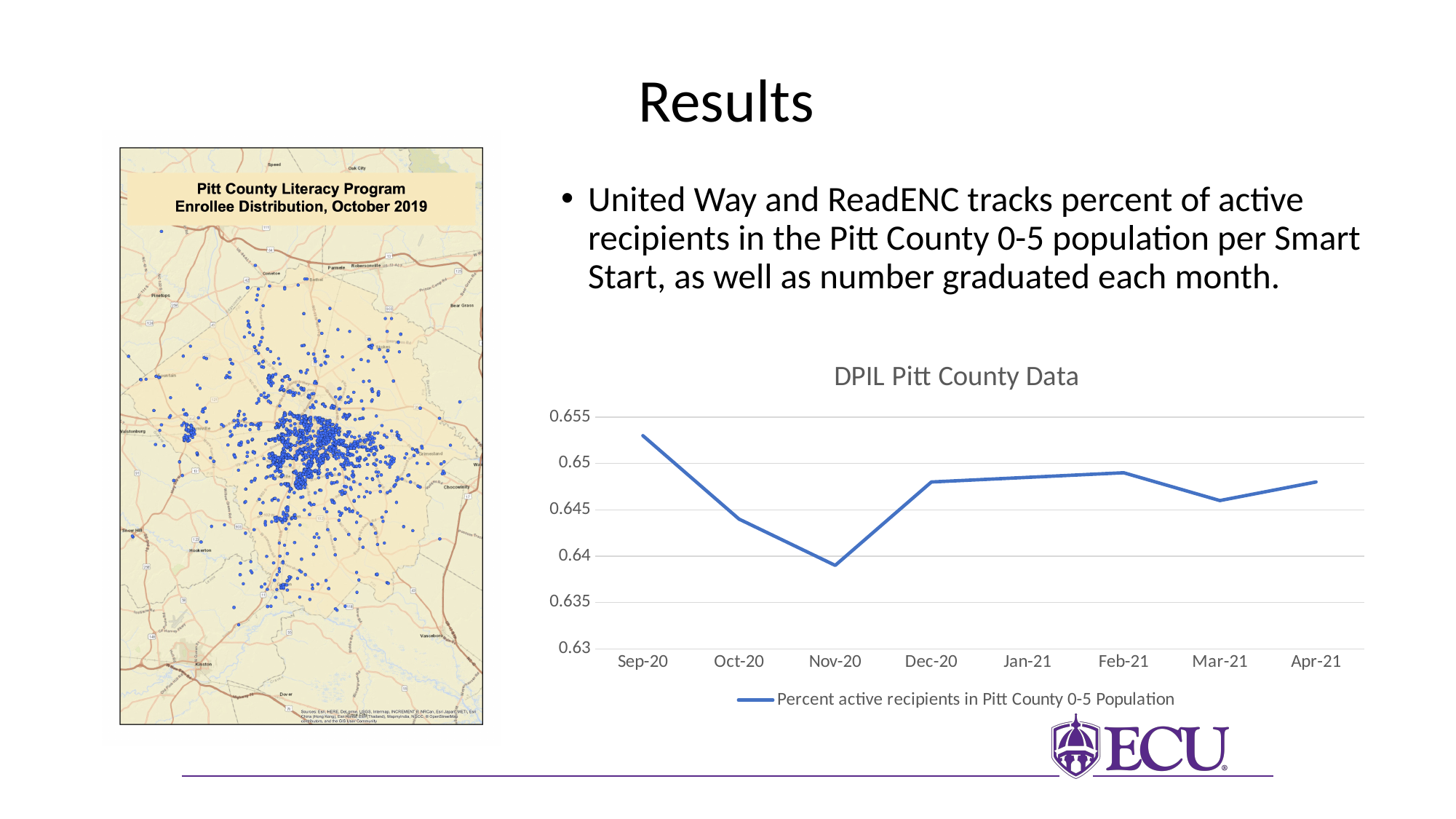
How many months are plotted on the x axis of the "DPIL Pitt County Data" chart? 8 In the "DPIL Pitt County Data" chart, is the value for Sep-20 greater or less than 0.65? greater In the "DPIL Pitt County Data" chart, is the value for Nov-20 greater or less than 0.64? less In the "DPIL Pitt County Data" chart, which is larger, the value for Nov-20 or Dec-20? Dec-20 What is the legend entry for the series in the "DPIL Pitt County Data" chart? Percent active recipients in Pitt County 0-5 Population In the "DPIL Pitt County Data" chart, which month has the highest value? Sep-20 In the "DPIL Pitt County Data" chart, which is larger, the value for Feb-21 or Mar-21? Feb-21 In the "DPIL Pitt County Data" chart, which month has the lowest value? Nov-20 In the "DPIL Pitt County Data" chart, is the value for Mar-21 greater or less than 0.645? greater What kind of chart is the "DPIL Pitt County Data" chart? line chart In the "DPIL Pitt County Data" chart, does the value rise or fall from Sep-20 to Nov-20? fall